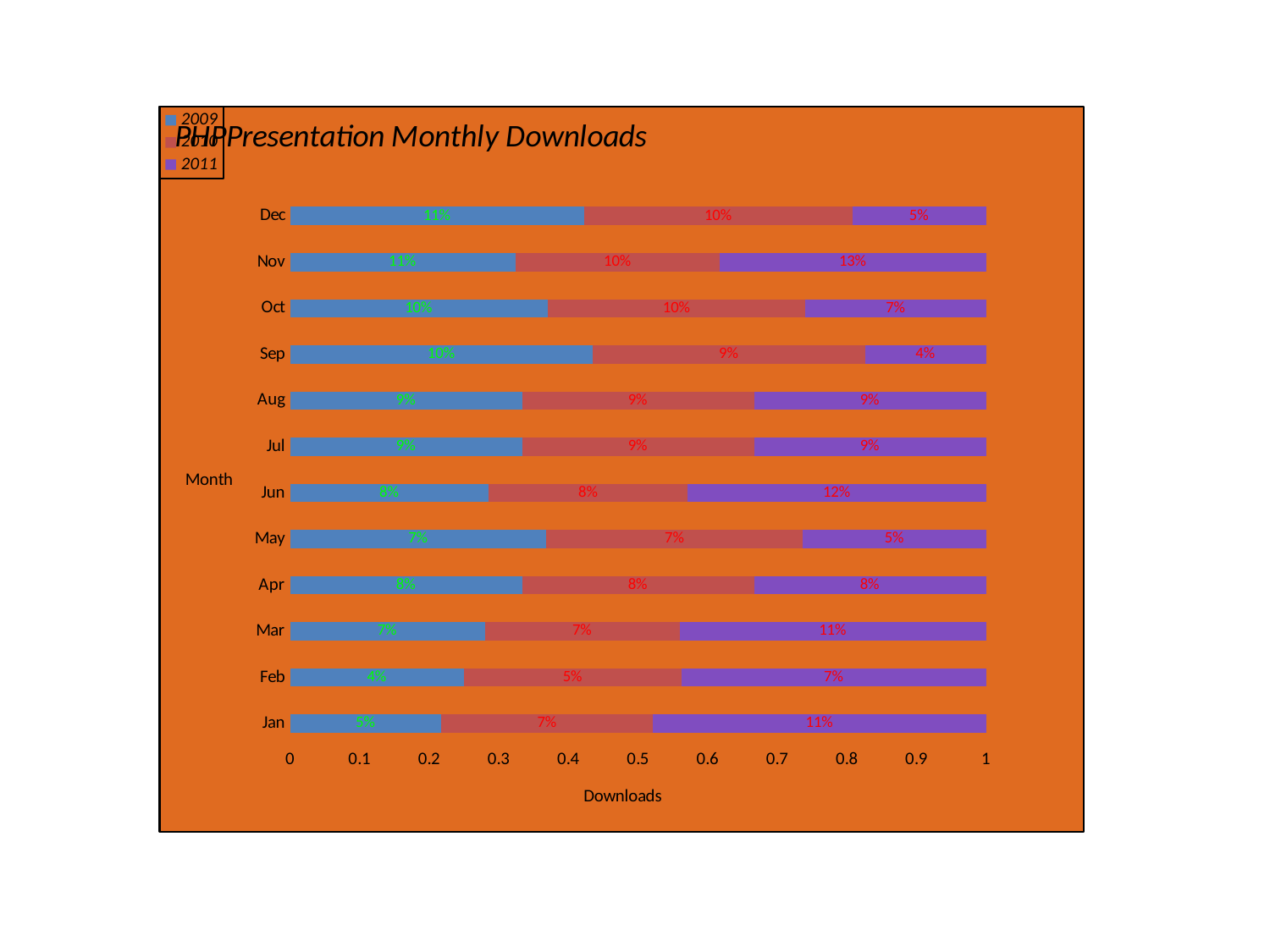
Which is larger, the 2011 value for Mar or the 2011 value for Dec? Mar What is the 2010 value for Jan? 7% What is the 2009 value for Feb? 4% Which month has the highest 2011 value? Nov What kind of chart is shown on the slide? Stacked bar chart What is the difference between the 2011 value for Jun and the 2011 value for May? 7% What is the 2011 value for Sep? 4% What is the 2011 value for Nov? 13% Which month has the lowest 2009 value? Feb What is the title of the chart? PHPPresentation Monthly Downloads How many series does the legend list? 3 How many months are shown on the chart? 12